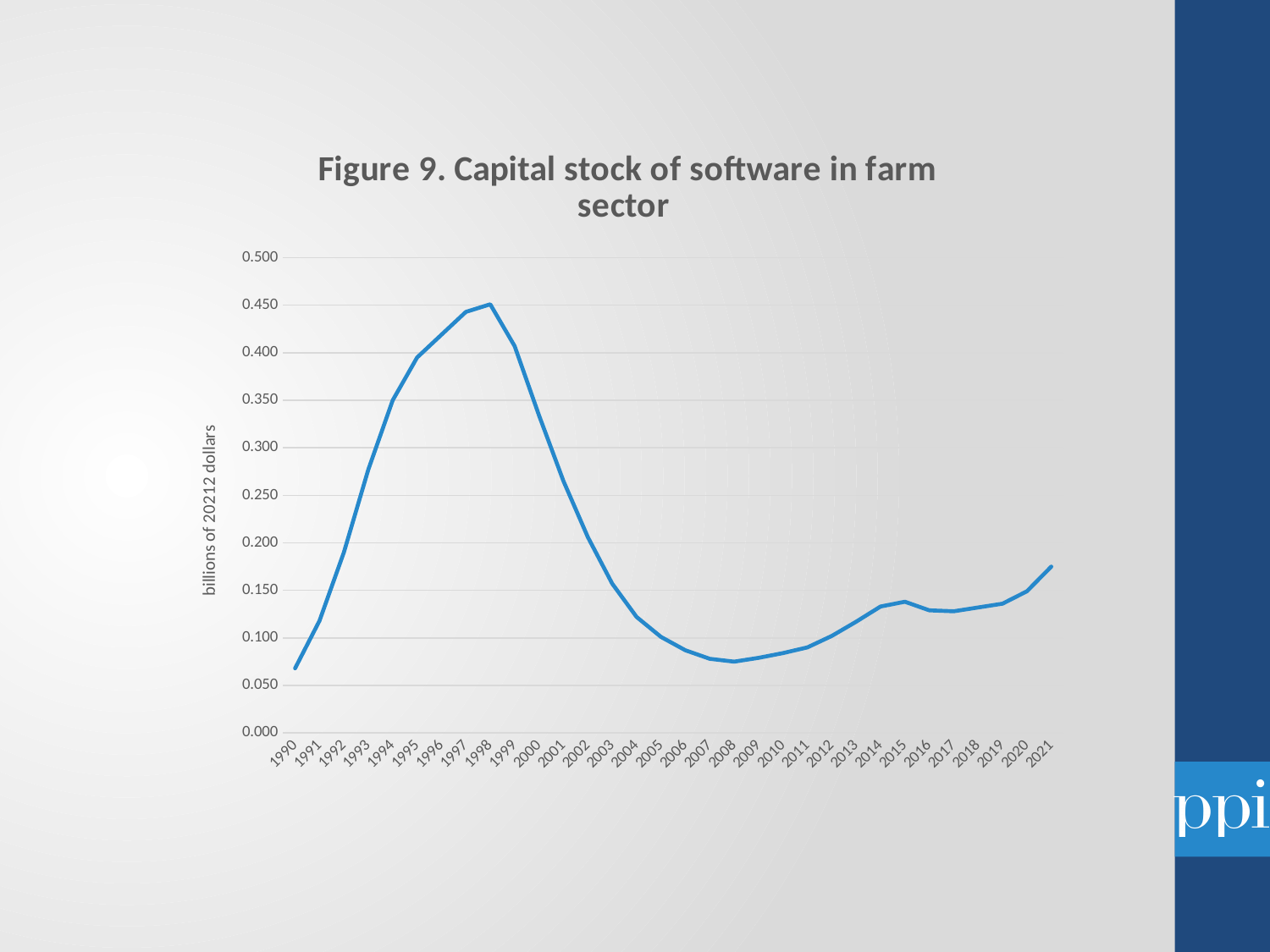
What is the title of the chart? Figure 9. Capital stock of software in farm sector What kind of chart is shown on the slide? line chart Is the value for 2008 greater or less than 0.100? less Is the value for 2021 greater or less than 0.150? greater Is the value for 1998 greater or less than 0.400? greater How many years are plotted along the x axis of the chart? 32 What is the label on the vertical axis of the chart? billions of 20212 dollars Which year has the larger value, 1998 or 2021? 1998 In which year does the capital stock of software in the farm sector reach its highest value? 1998 In which year does the capital stock of software in the farm sector reach its lowest value? 1990 Does the value rise or fall between 1998 and 2008? fall